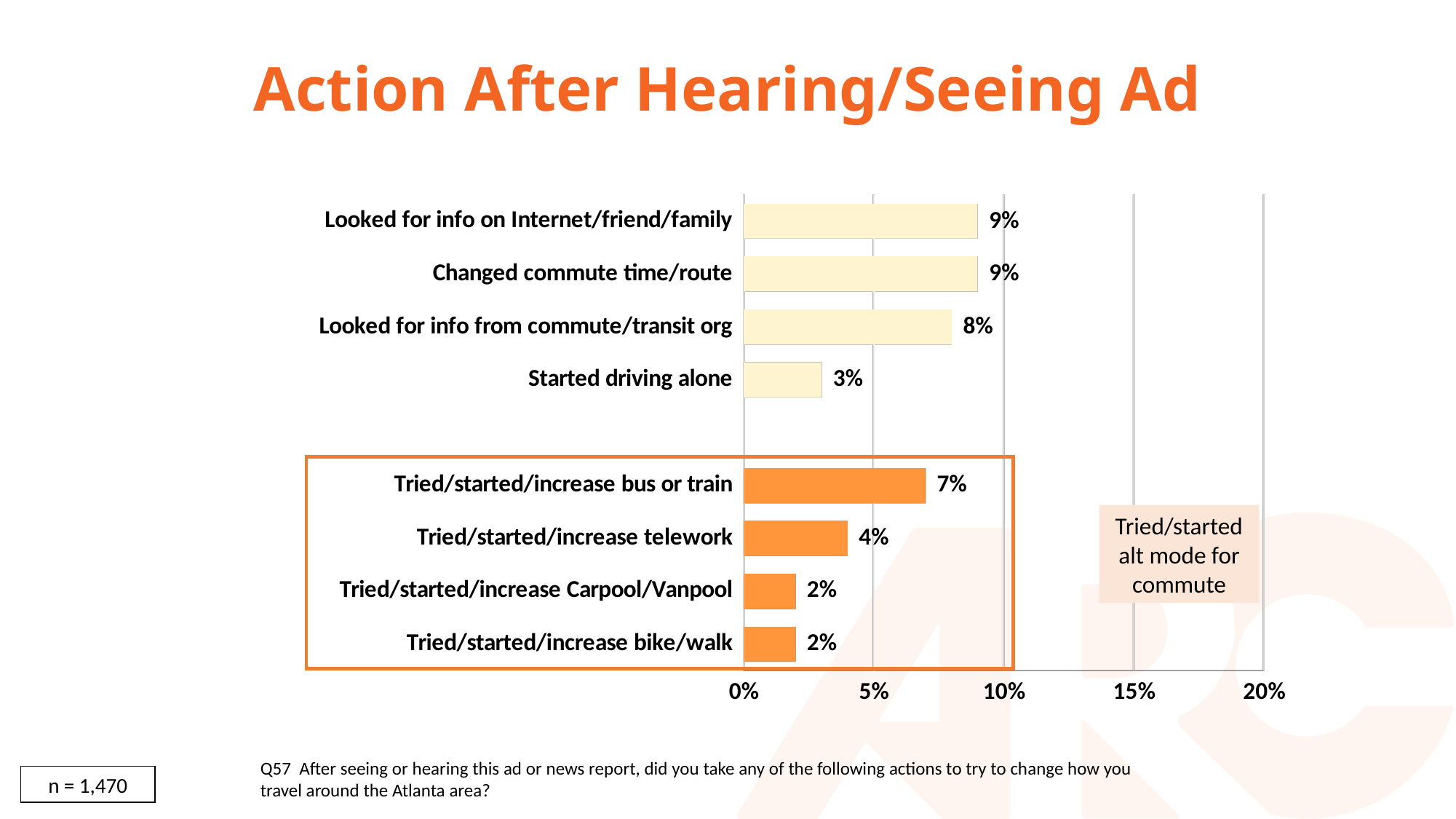
Is the value for 'Changed commute time/route' greater or less than 10%? less What percentage tried/started/increased telework? 4% Among the actions in the orange box (tried/started alt mode for commute), which has the highest value? Tried/started/increase bus or train What type of chart is shown on the slide? Bar chart What is the value for 'Started driving alone'? 3% What is the difference between 'Changed commute time/route' and 'Started driving alone'? 6% What percentage of respondents looked for info on Internet/friend/family? 9% How many action categories are shown in the chart? 8 What is the value for 'Looked for info from commute/transit org'? 8% What is the difference between 'Tried/started/increase bus or train' and 'Tried/started/increase telework'? 3% What is the title of the slide? Action After Hearing/Seeing Ad Which is larger: 'Looked for info from commute/transit org' or 'Tried/started/increase bus or train'? Looked for info from commute/transit org